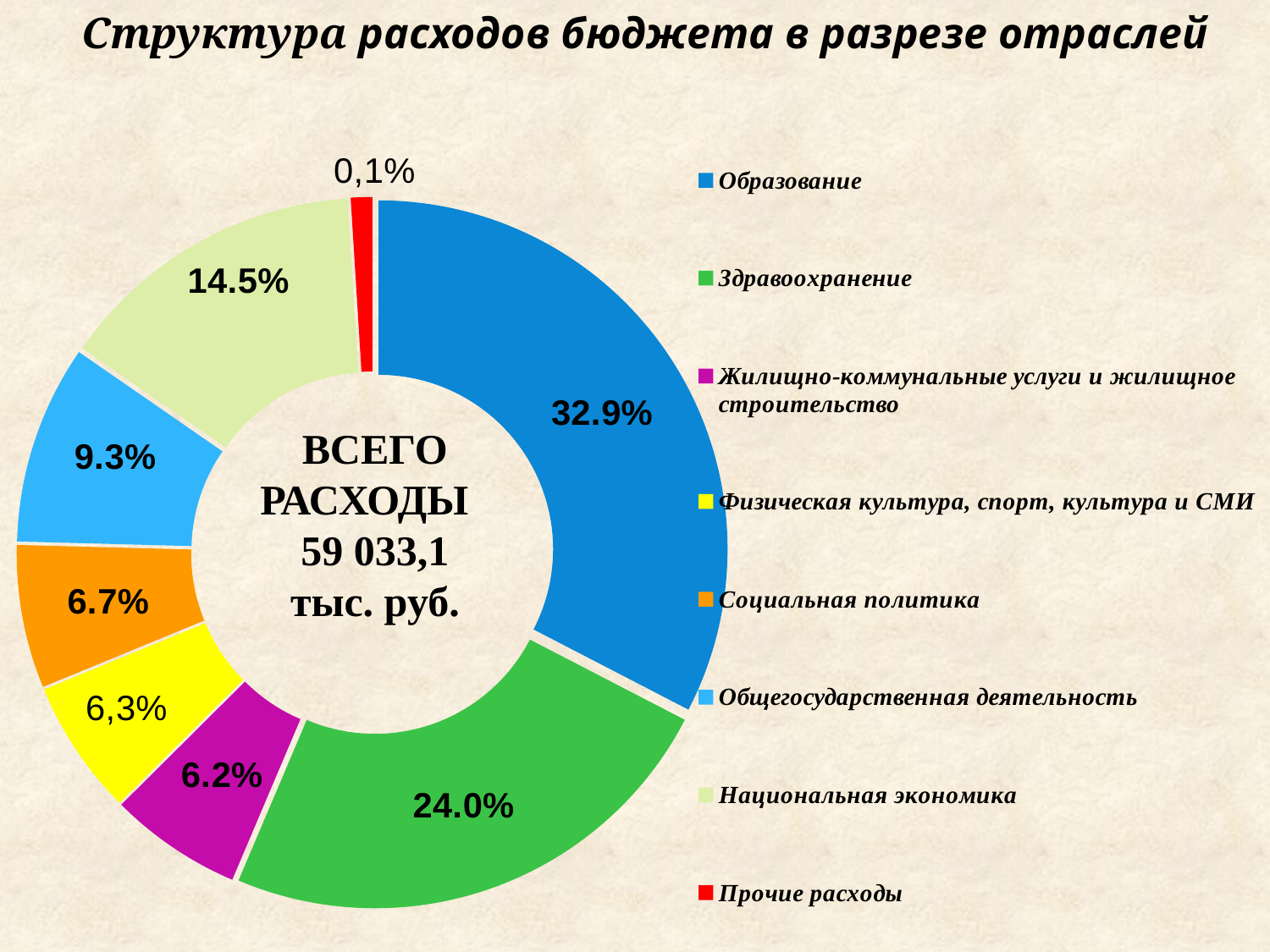
Which sector has the smallest share of budget expenditures? Прочие расходы What total expenditure amount is shown in the centre of the chart? 59 033,1 тыс. руб. What share of budget expenditures goes to Здравоохранение? 24.0% How many percentage points larger is the share of Образование than the share of Здравоохранение? 8.9% How many sectors does the legend list? 8 What share of budget expenditures goes to Национальная экономика? 14.5% What share of budget expenditures goes to Прочие расходы? 0,1% What share of budget expenditures goes to Образование? 32.9% What share of budget expenditures goes to Общегосударственная деятельность? 9.3% What kind of chart is shown on the slide? Pie chart (doughnut) Which has the larger share: Социальная политика or Жилищно-коммунальные услуги и жилищное строительство? Социальная политика Which sector has the largest share of budget expenditures? Образование